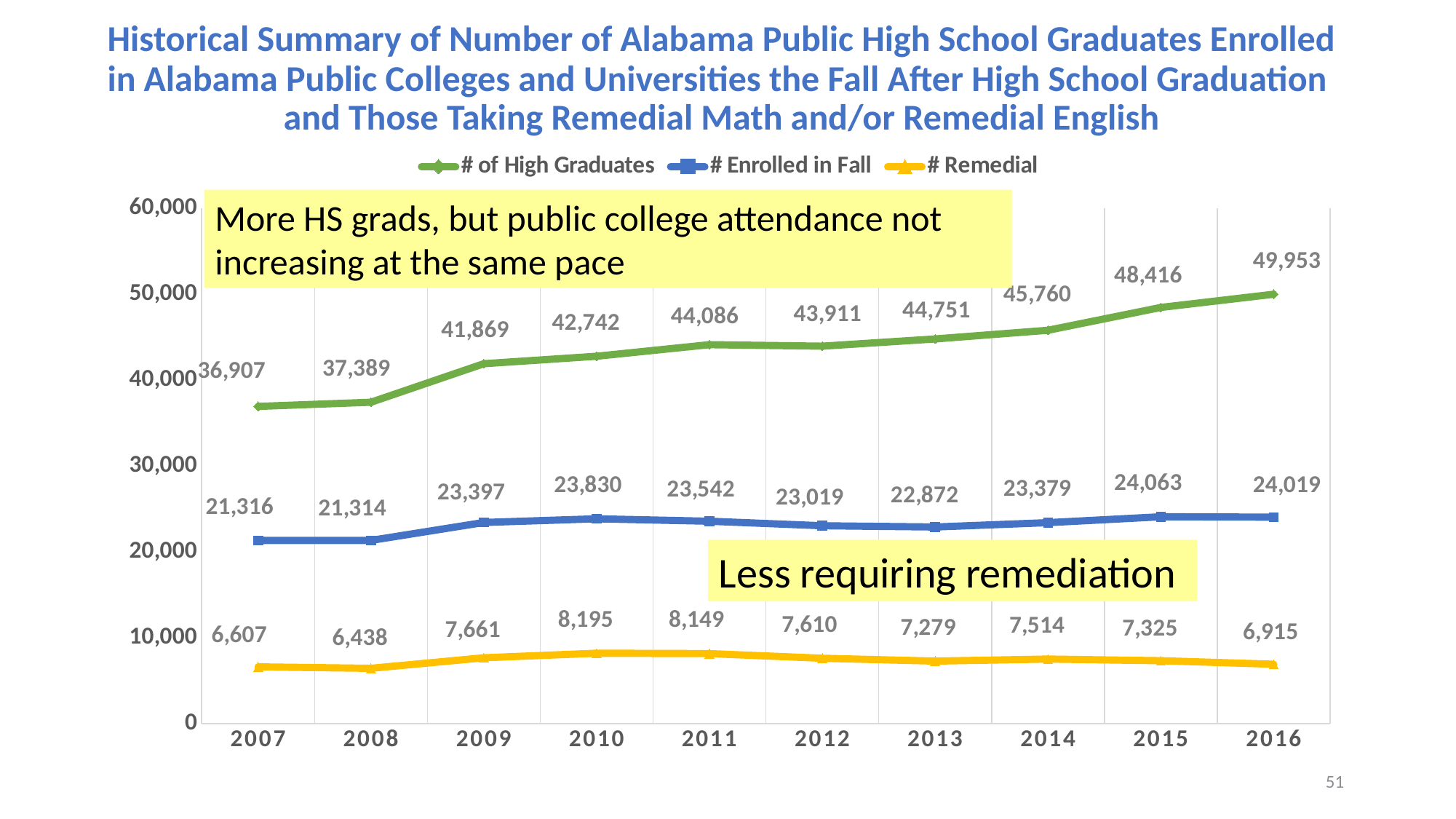
What is the difference between # of High Graduates in 2016 and in 2007? 13,046 What kind of chart is shown on the slide? line chart Which is larger: # Enrolled in Fall in 2015 or in 2016? 2015 In which year is the # of High Graduates series lowest? 2007 What is the value for # Remedial in 2013? 7,279 Does the # of High Graduates series generally rise or fall from 2007 to 2016? rise How many series does the legend list? 3 In which year is the # Remedial series highest? 2010 What is the value for # of High Graduates in 2016? 49,953 Is the value for # of High Graduates in 2014 greater or less than 40,000? greater What is the value for # Enrolled in Fall in 2010? 23,830 How many years are shown on the x axis? 10